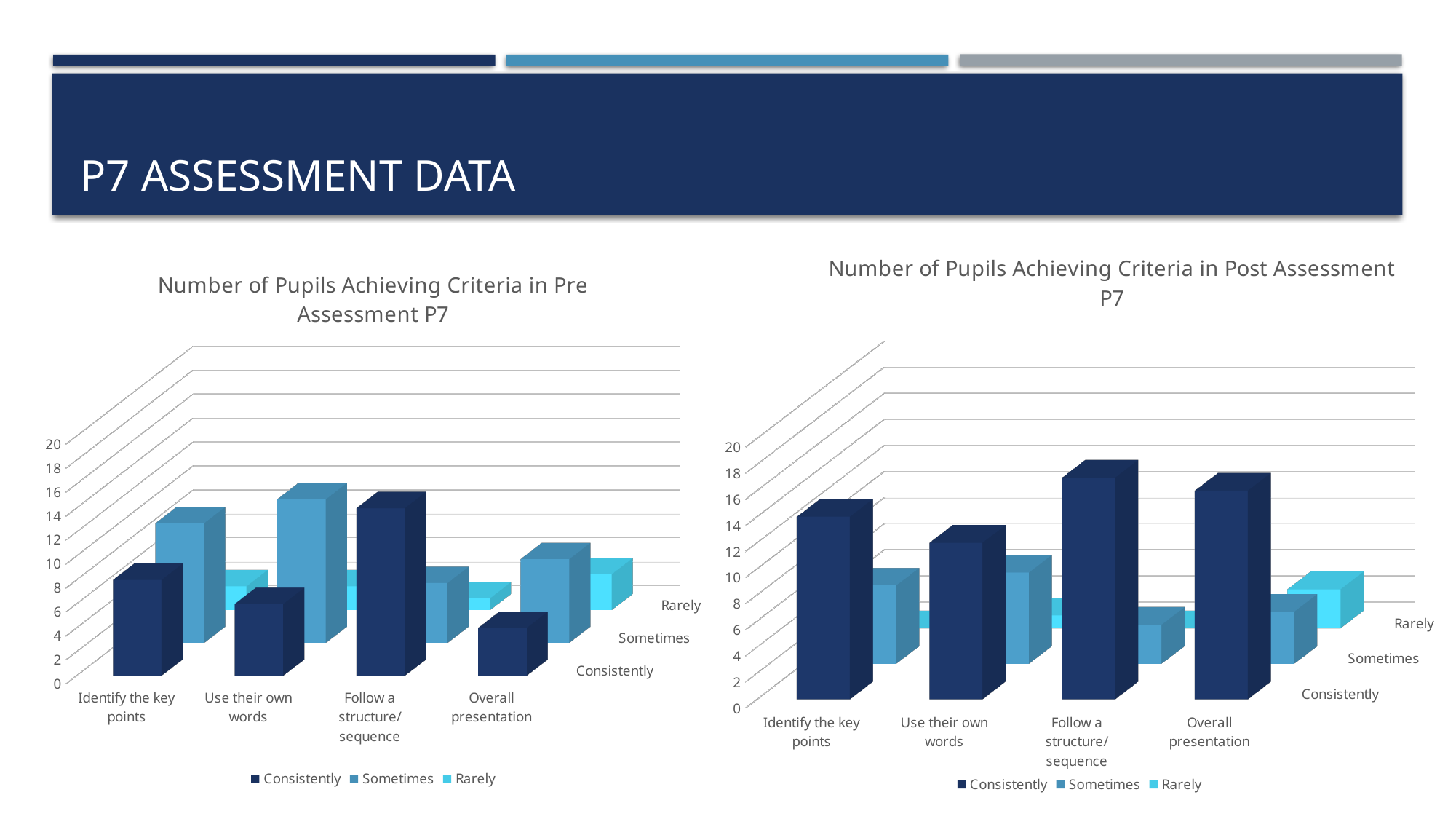
In the Pre Assessment P7 chart, which criterion has the highest 'Consistently' value? Follow a structure/ sequence What is the title of the chart on the right of the slide? Number of Pupils Achieving Criteria in Post Assessment P7 In the Post Assessment P7 chart, how many series does the legend list? 3 In the Pre Assessment P7 chart, which criterion has the lowest 'Consistently' value? Overall presentation What type of chart is the 'Number of Pupils Achieving Criteria in Post Assessment P7' chart? bar chart In the Pre Assessment P7 chart, how many criteria categories are shown on the x axis? 4 In the Post Assessment P7 chart, is the 'Consistently' value for 'Follow a structure/ sequence' larger or smaller than its 'Sometimes' value? larger In the Pre Assessment P7 chart, is the 'Sometimes' value for 'Use their own words' larger or smaller than its 'Consistently' value? larger In the Pre Assessment P7 chart, is the 'Consistently' value for 'Follow a structure/ sequence' larger or smaller than the 'Consistently' value for 'Overall presentation'? larger In the Pre Assessment P7 chart, what are the three series listed in the legend? Consistently, Sometimes, Rarely What type of chart is the 'Number of Pupils Achieving Criteria in Pre Assessment P7' chart? bar chart In the Post Assessment P7 chart, which criterion has the lowest 'Consistently' value? Use their own words